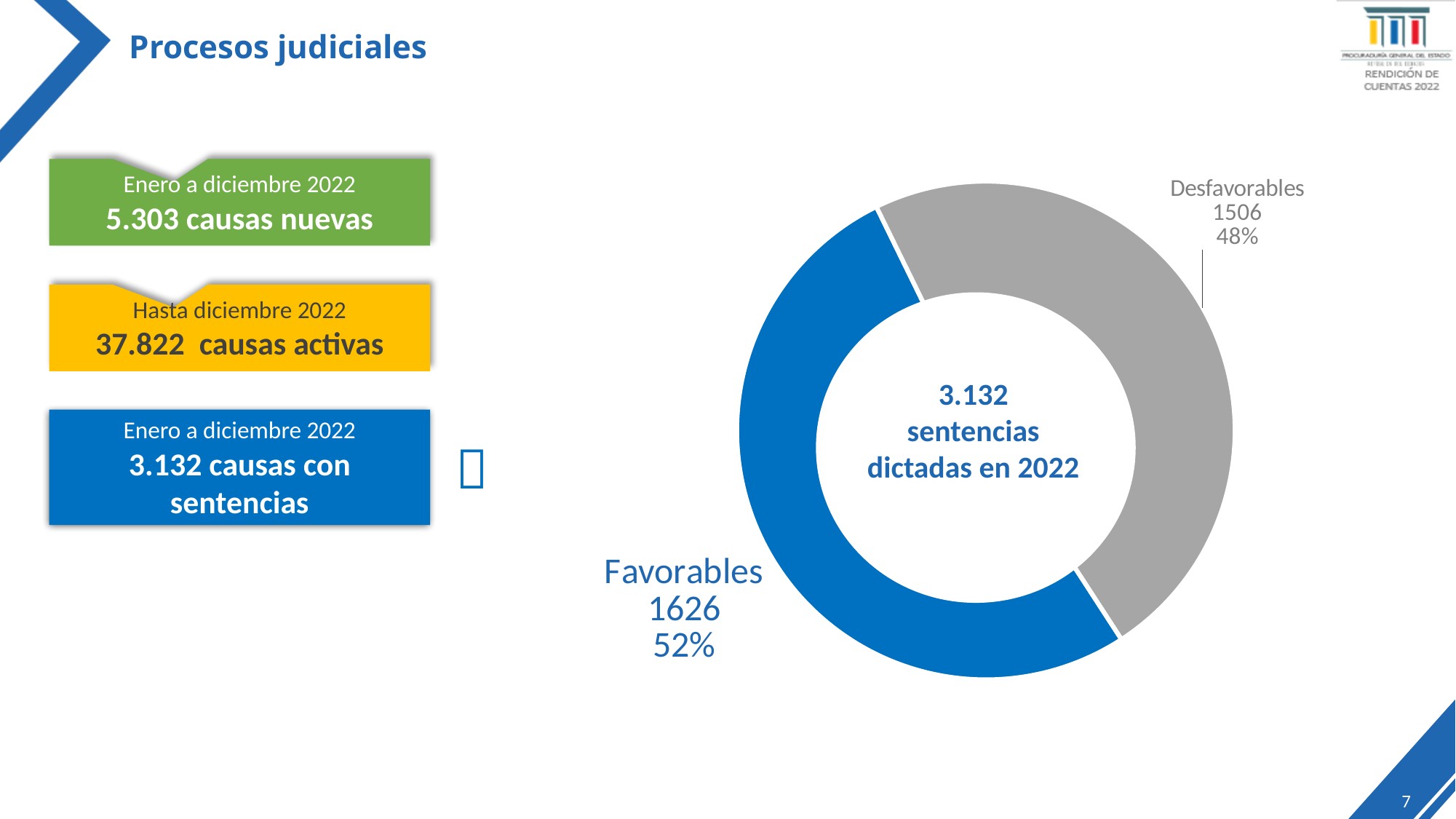
What share of the doughnut chart is Desfavorables? 48% What is the difference between the Favorables and Desfavorables values? 120 What text is shown in the centre of the doughnut chart? 3.132 sentencias dictadas en 2022 What share of the doughnut chart is Favorables? 52% How many slices does the doughnut chart have? 2 What is the value for Desfavorables? 1506 What colour is the Desfavorables slice? Grey What kind of chart is shown on the slide? Doughnut chart What is the value for Favorables? 1626 Which is larger, Favorables or Desfavorables? Favorables Which slice is the largest in the doughnut chart? Favorables Which slice is the smallest in the doughnut chart? Desfavorables